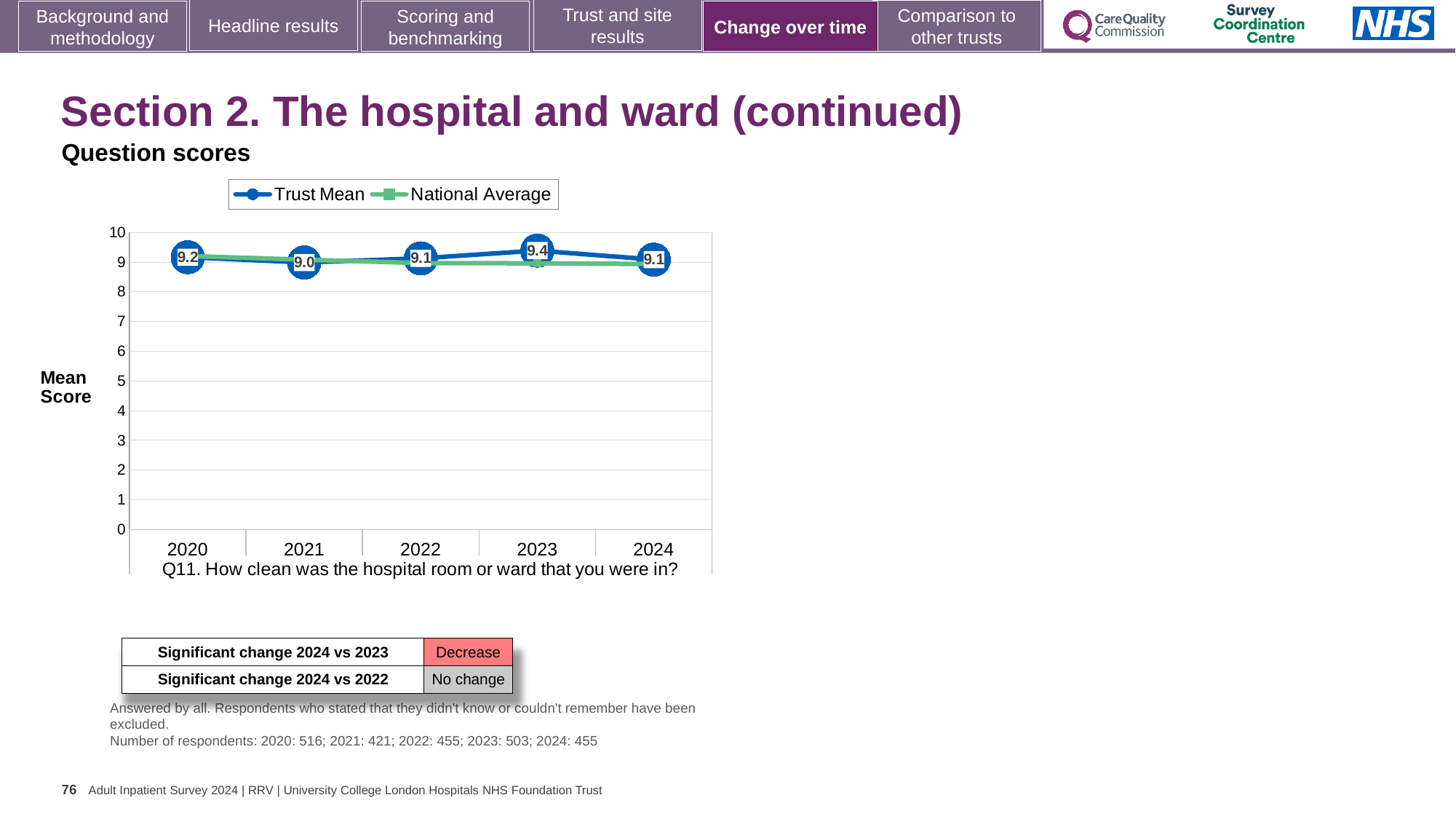
What is the difference between the Trust Mean in 2023 and in 2024? 0.3 Which year has the larger Trust Mean, 2020 or 2021? 2020 What is the Trust Mean value for 2023? 9.4 Is the National Average value for 2024 greater or less than 8? greater Does the Trust Mean rise or fall from 2023 to 2024? Fall What kind of chart is shown on the slide? Line chart What is the Trust Mean value for 2021? 9.0 How many series does the chart legend list? 2 What is the Trust Mean value for 2024? 9.1 In which year is the Trust Mean highest? 2023 How many years are shown on the x axis of the chart? 5 In which year is the Trust Mean lowest? 2021